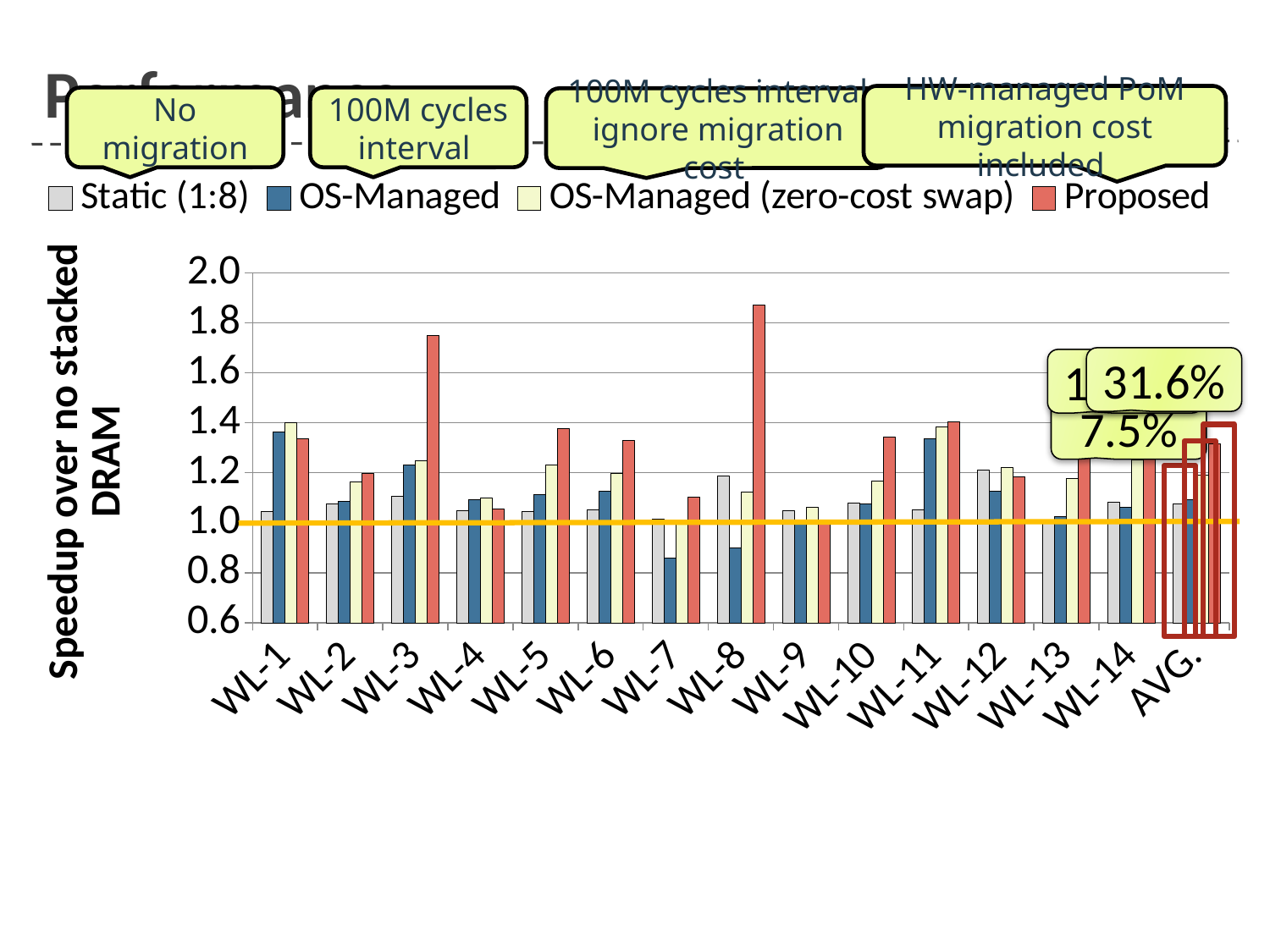
How many categories are shown along the x axis? 15 Is the Proposed value for WL-8 greater or less than 1.8? greater For WL-1, which is larger: the Static (1:8) bar or the OS-Managed (zero-cost swap) bar? OS-Managed (zero-cost swap) Which workload has the lowest OS-Managed bar? WL-7 Which workload has the highest Proposed bar? WL-8 What kind of chart is shown on the slide? bar chart Is the Proposed value for WL-4 greater or less than 1.2? less Is the OS-Managed value for WL-7 greater or less than 1.0? less For WL-3, which is larger: the OS-Managed bar or the Proposed bar? Proposed What is the label on the y axis? Speedup over no stacked DRAM How many series does the legend list? 4